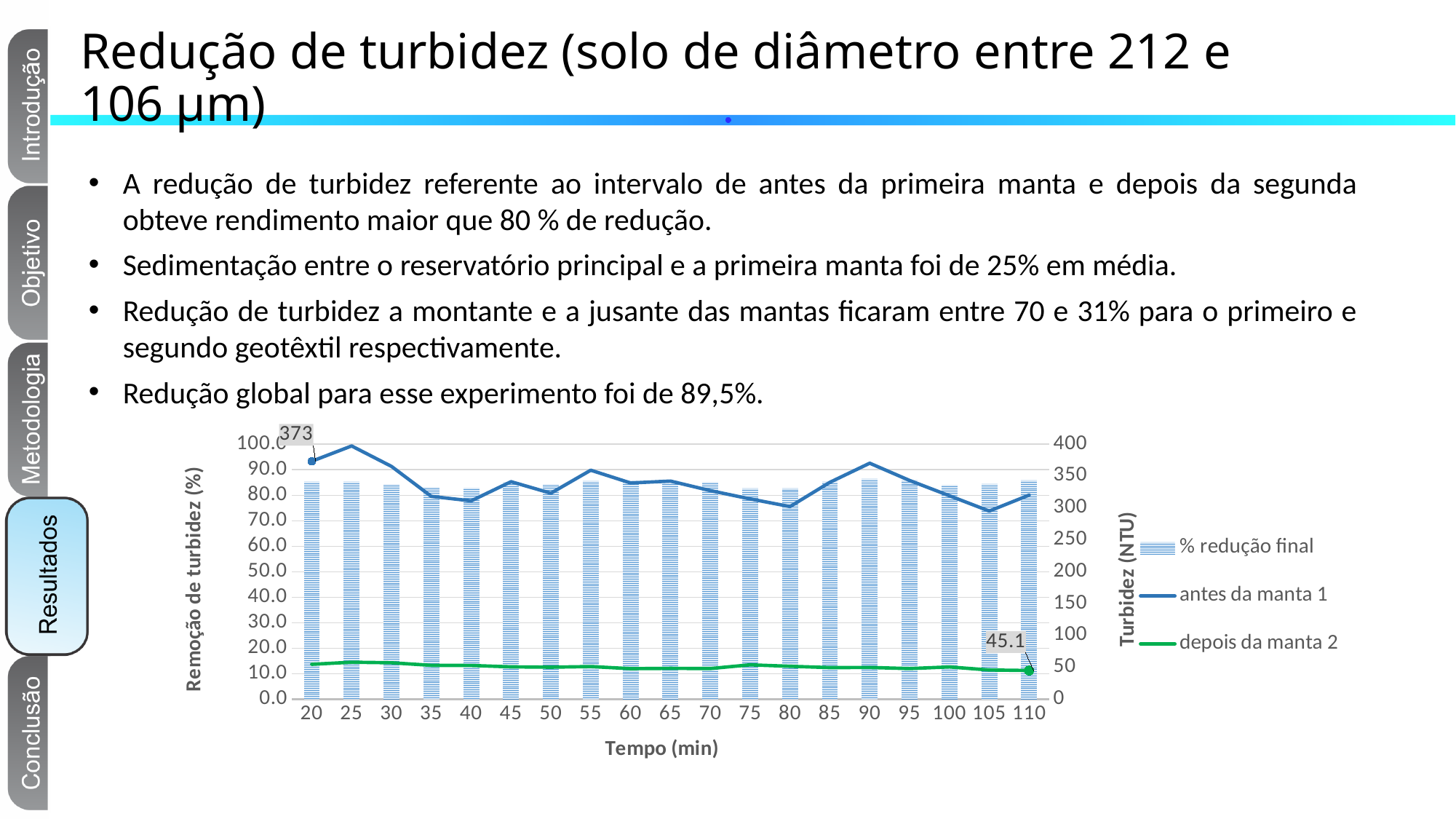
What is the value of 'antes da manta 1' at 20 min? 373 How many series does the legend list? 3 What is the title of the x axis? Tempo (min) What is the title of the right-hand y axis? Turbidez (NTU) Is the 'antes da manta 1' value at 25 min greater or less than 350? greater Is the 'depois da manta 2' value at 20 min greater or less than 100? less Is the '% redução final' value at 20 min greater or less than 90? less What kind of chart is this? Combined bar and line chart At which time is the 'antes da manta 1' value highest? 25 What is the value of 'depois da manta 2' at 110 min? 45.1 Does the 'antes da manta 1' line rise or fall from 90 min to 105 min? fall How many time points are shown on the x axis? 19